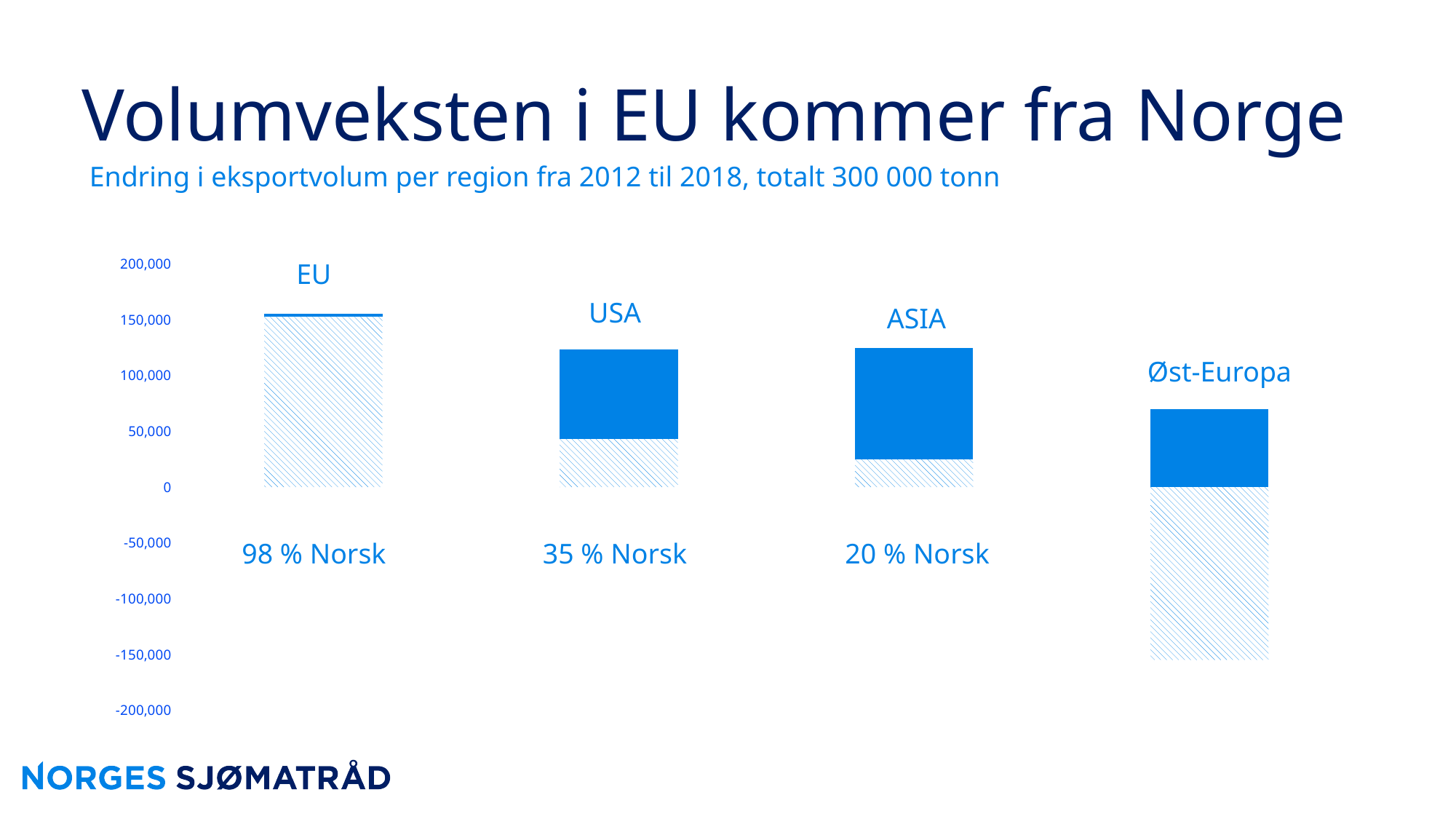
Which region has the highest bar in the chart? EU How many regions are shown in the chart? 4 Is the top of the USA bar greater or less than 100,000? greater What percentage is labelled as Norwegian (Norsk) under the ASIA bar? 20 % Which bar reaches higher, EU or USA? EU According to the chart subtitle, what is the total change in export volume from 2012 to 2018? 300 000 tonn Is the top of the ASIA bar greater or less than 150,000? less Which region is the only one with a negative (below zero) portion in the chart? Øst-Europa What percentage is labelled as Norwegian (Norsk) under the USA bar? 35 % Is the top of the EU bar greater or less than 100,000? greater What kind of chart is shown on the slide? bar chart